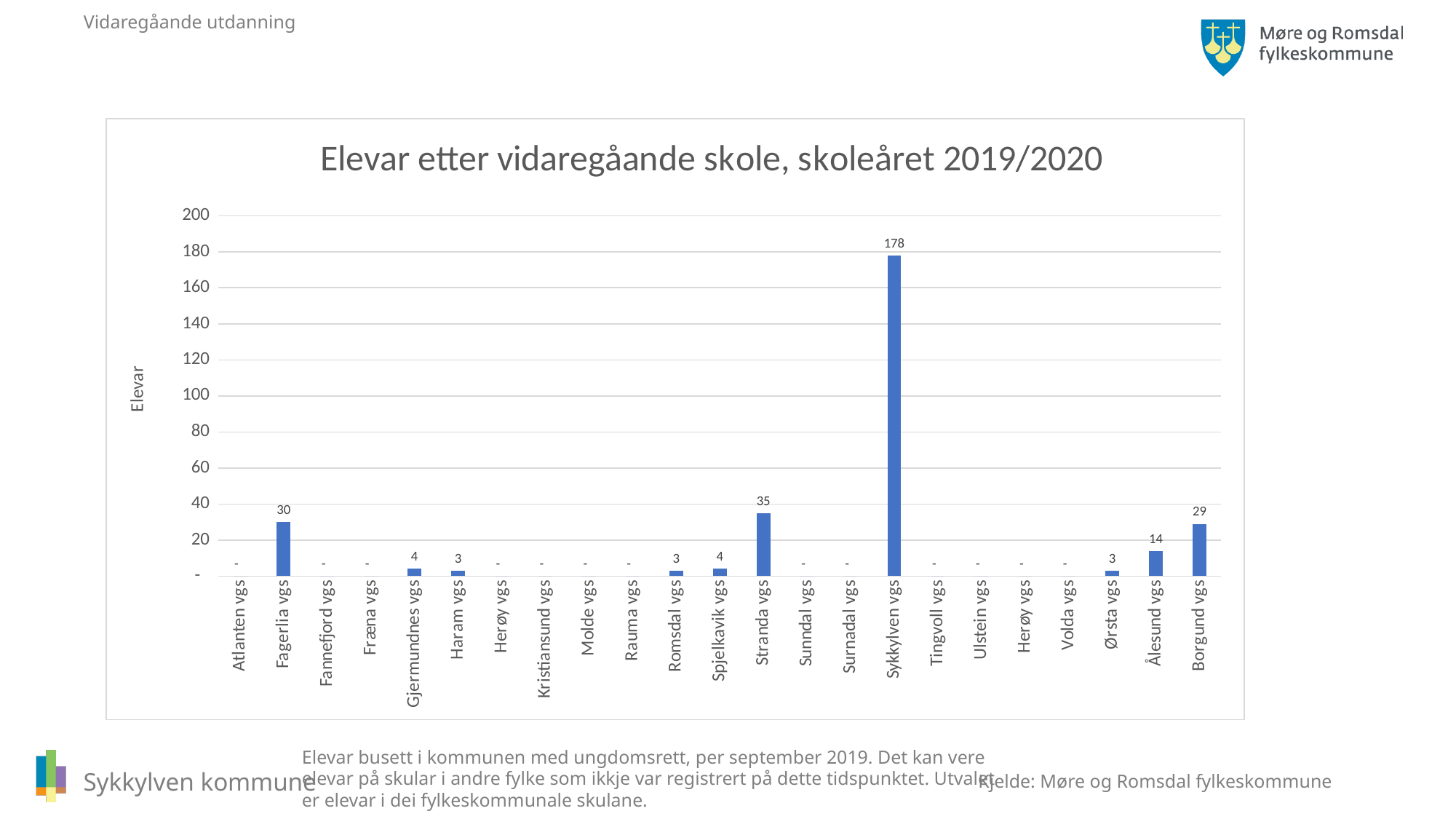
What is the difference between the values for Sykkylven vgs and Stranda vgs? 143 How many schools are listed on the x axis? 23 What is the value for Borgund vgs? 29 Which school has the highest number of students? Sykkylven vgs What kind of chart is shown on the slide? Bar chart Which has a larger value, Stranda vgs or Fagerlia vgs? Stranda vgs What is the title of the chart? Elevar etter vidaregåande skole, skoleåret 2019/2020 What is the difference between the values for Fagerlia vgs and Borgund vgs? 1 Is the value for Sykkylven vgs greater or less than 100? greater How many students are shown for Sykkylven vgs? 178 What is the value for Ålesund vgs? 14 What is the value for Stranda vgs? 35